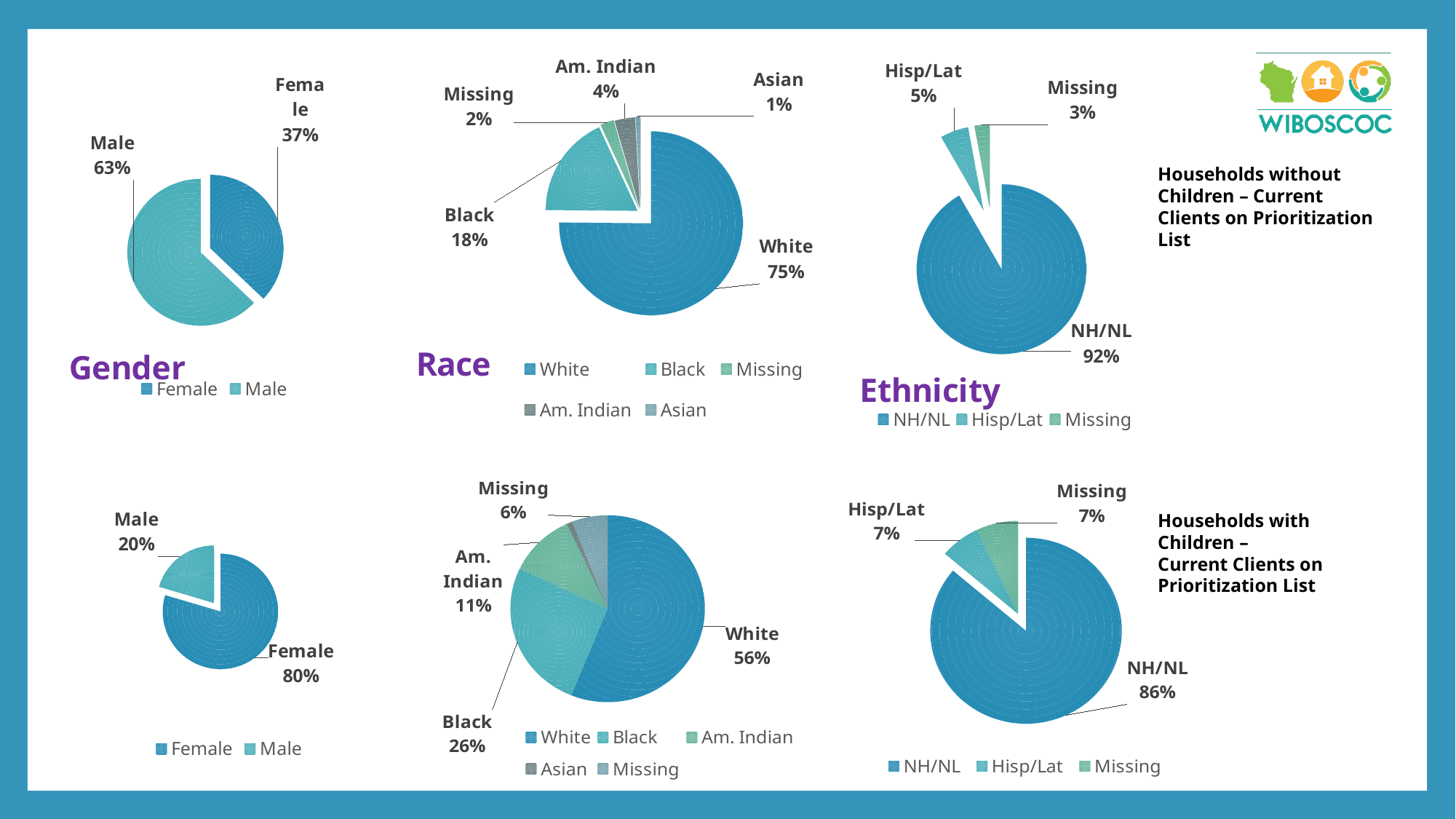
How many categories does the legend of the top-row Race pie chart (Households without Children) list? 5 In the top-row Race pie chart (Households without Children), which category has the smallest share? Asian In the bottom-row Gender pie chart (Households with Children), what percentage is Female? 80% In the top-row Ethnicity pie chart (Households without Children), what percentage is Hisp/Lat? 5% In the bottom-row Ethnicity pie chart (Households with Children), what percentage is NH/NL? 86% In the bottom-row Gender pie chart (Households with Children), which is larger, Female or Male? Female In the top-row Gender pie chart (Households without Children), what percentage is Male? 63% In the top-row Race pie chart (Households without Children), what is the difference between the White and Black shares? 57% In the bottom-row Race pie chart (Households with Children), which category has the largest share? White In the top-row Race pie chart (Households without Children), what percentage is Black? 18% In the bottom-row Race pie chart (Households with Children), what percentage is Am. Indian? 11% What type of chart is used for the Ethnicity data on this slide? Pie chart